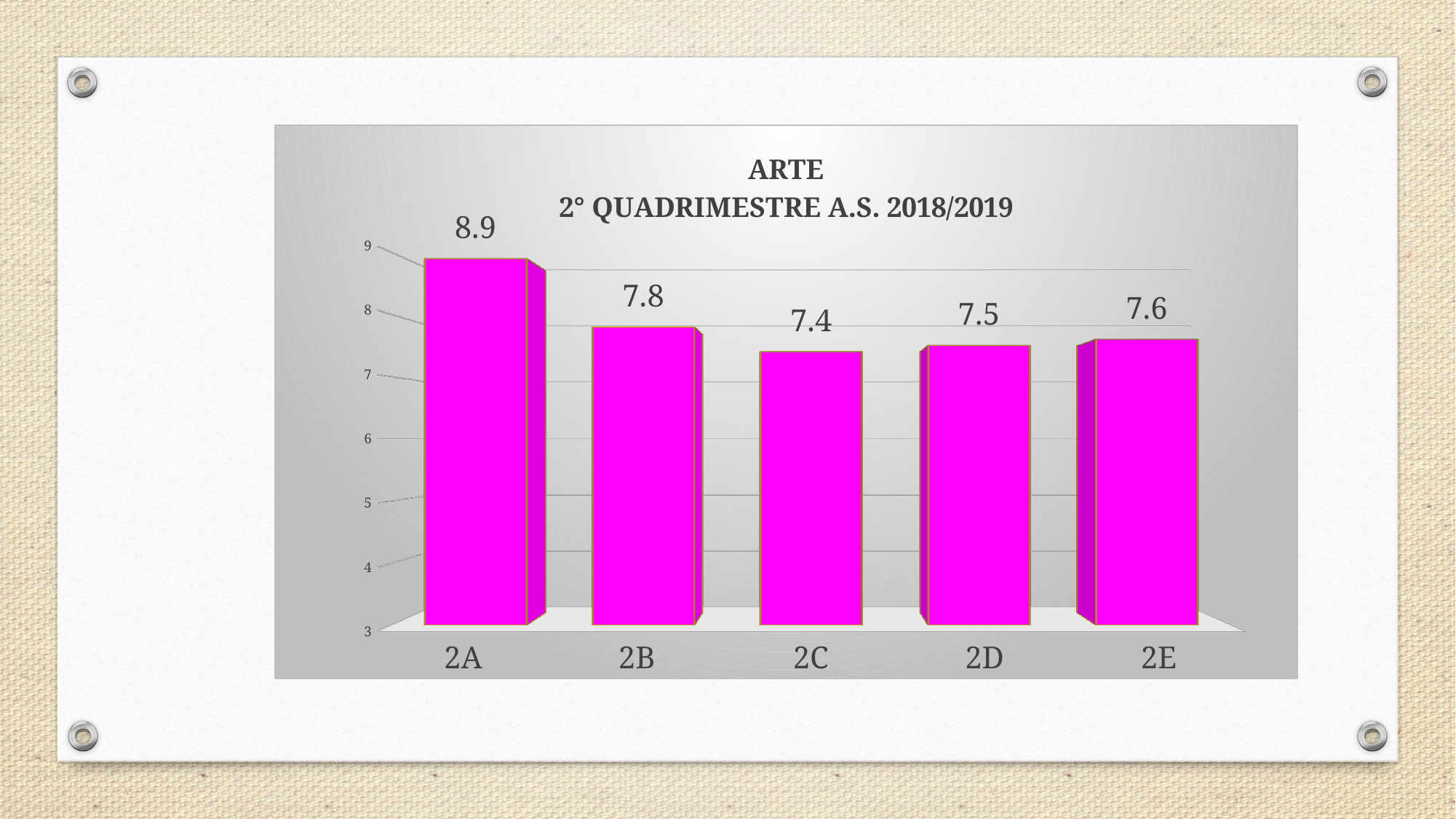
What is the difference between the values for 2A and 2B? 1.1 What kind of chart is this? bar chart What is the title of the chart? ARTE 2° QUADRIMESTRE A.S. 2018/2019 Which class has the highest value? 2A How many classes are shown on the x axis? 5 Which class has the lowest value? 2C What is the value for 2C? 7.4 What is the value for 2A? 8.9 Is the value for 2A greater or less than 8? greater Which is larger, the value for 2B or the value for 2C? 2B What is the difference between the values for 2E and 2D? 0.1 What is the value for 2E? 7.6